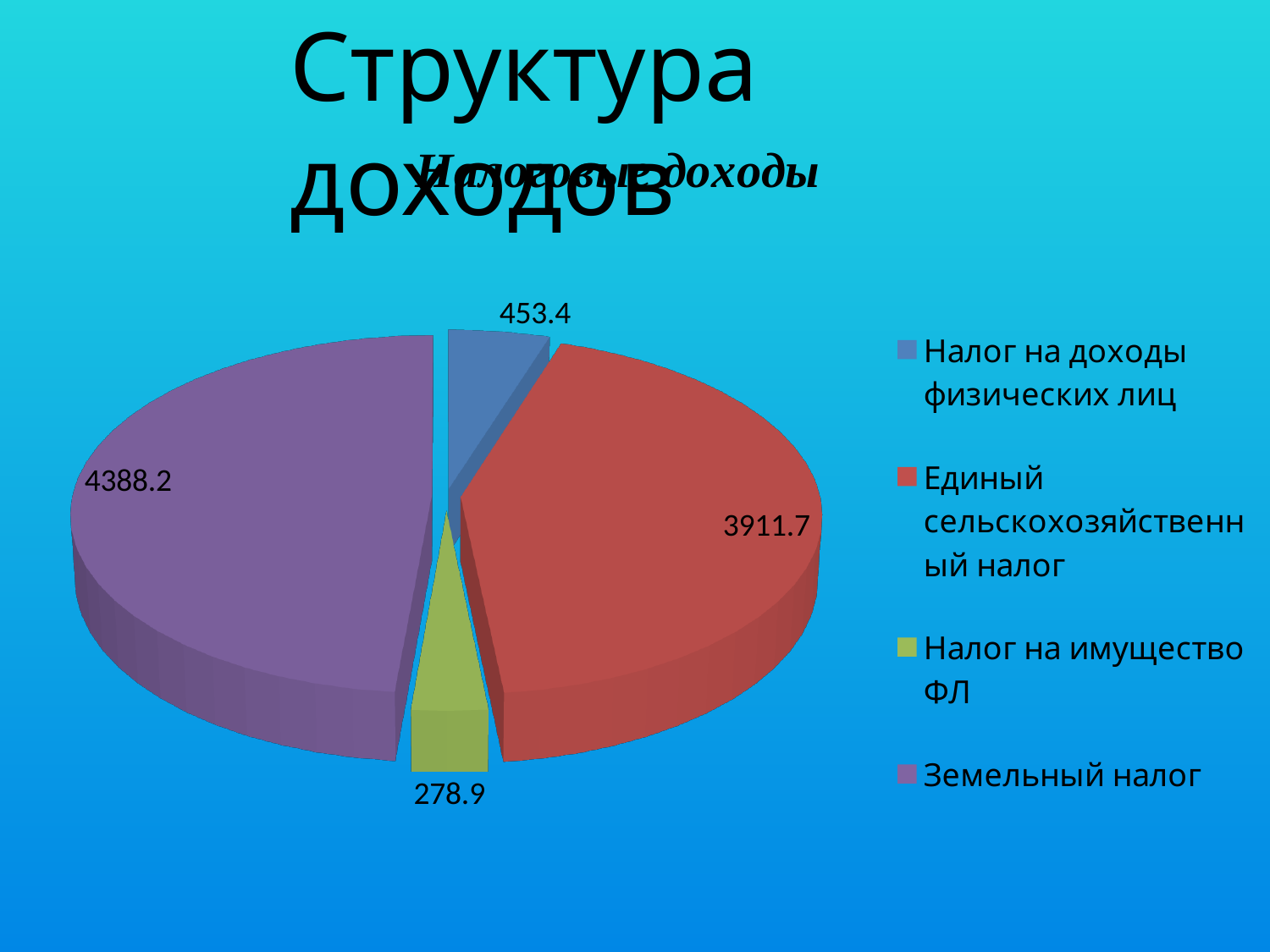
What is the value for Земельный налог? 4388.2 Which category has the largest slice of the pie? Земельный налог What is the value for Налог на имущество ФЛ? 278.9 How many categories does the pie chart have? 4 What colour is the slice for Единый сельскохозяйственный налог? Red Which category has the smallest slice of the pie? Налог на имущество ФЛ Which is larger: Налог на доходы физических лиц or Налог на имущество ФЛ? Налог на доходы физических лиц What is the value for Единый сельскохозяйственный налог? 3911.7 What is the total of all slices in the pie chart? 9032.2 What type of chart is shown on the slide? Pie chart What is the difference between the values for Земельный налог and Единый сельскохозяйственный налог? 476.5 What is the value for Налог на доходы физических лиц? 453.4